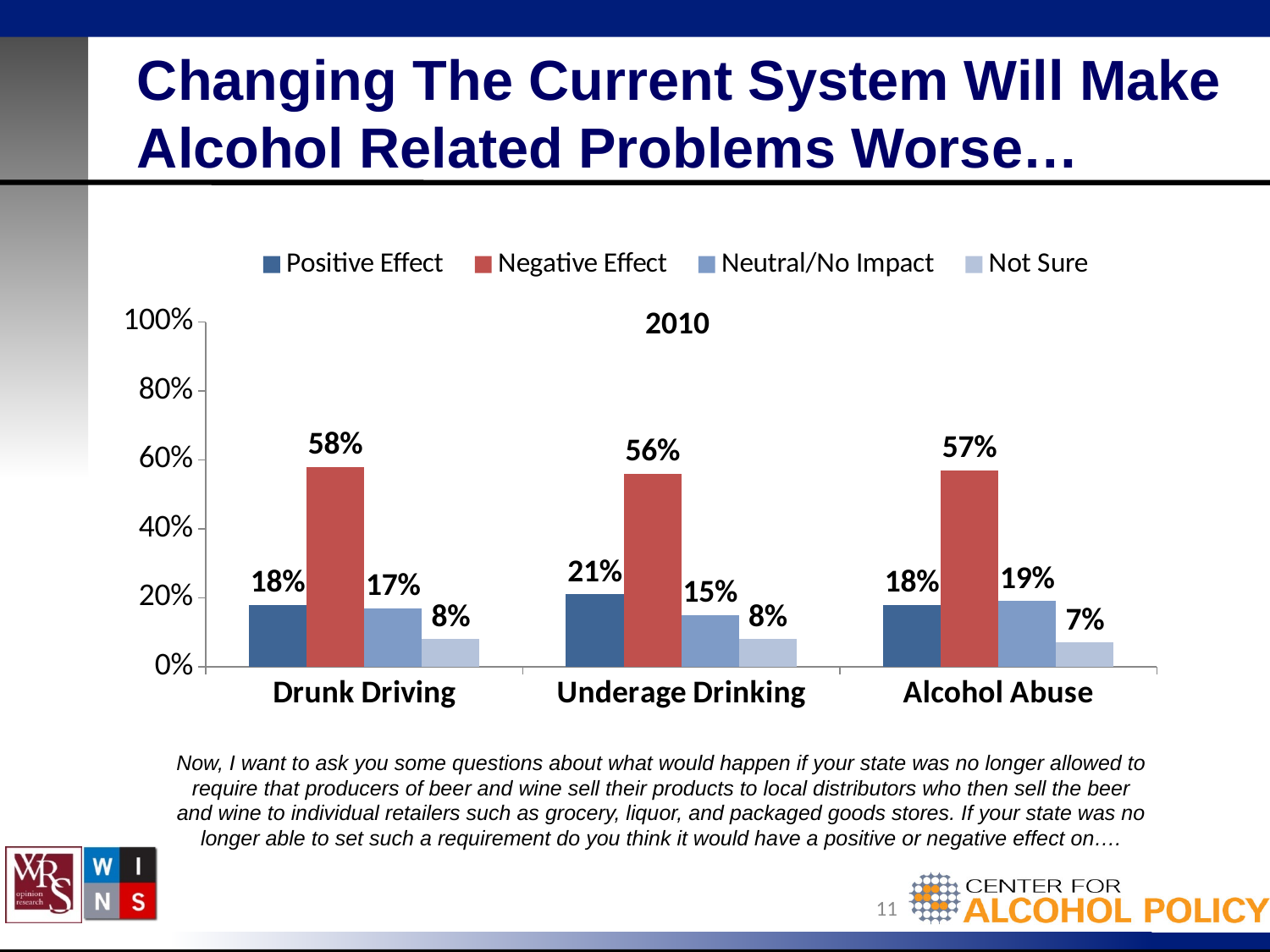
What is the value for Not Sure for Alcohol Abuse? 7% Which category has the highest Negative Effect value? Drunk Driving What is the value for Negative Effect for Drunk Driving? 58% What kind of chart is shown on the slide? Bar chart How many categories are shown on the x axis? 3 What year is shown as the label above the chart? 2010 Which category has the lowest Not Sure value? Alcohol Abuse How many series does the legend list? 4 What is the value for Positive Effect for Underage Drinking? 21% What is the difference between the Negative Effect and Positive Effect values for Underage Drinking? 35% What is the value for Neutral/No Impact for Alcohol Abuse? 19% Which is larger for Alcohol Abuse: Positive Effect or Neutral/No Impact? Neutral/No Impact